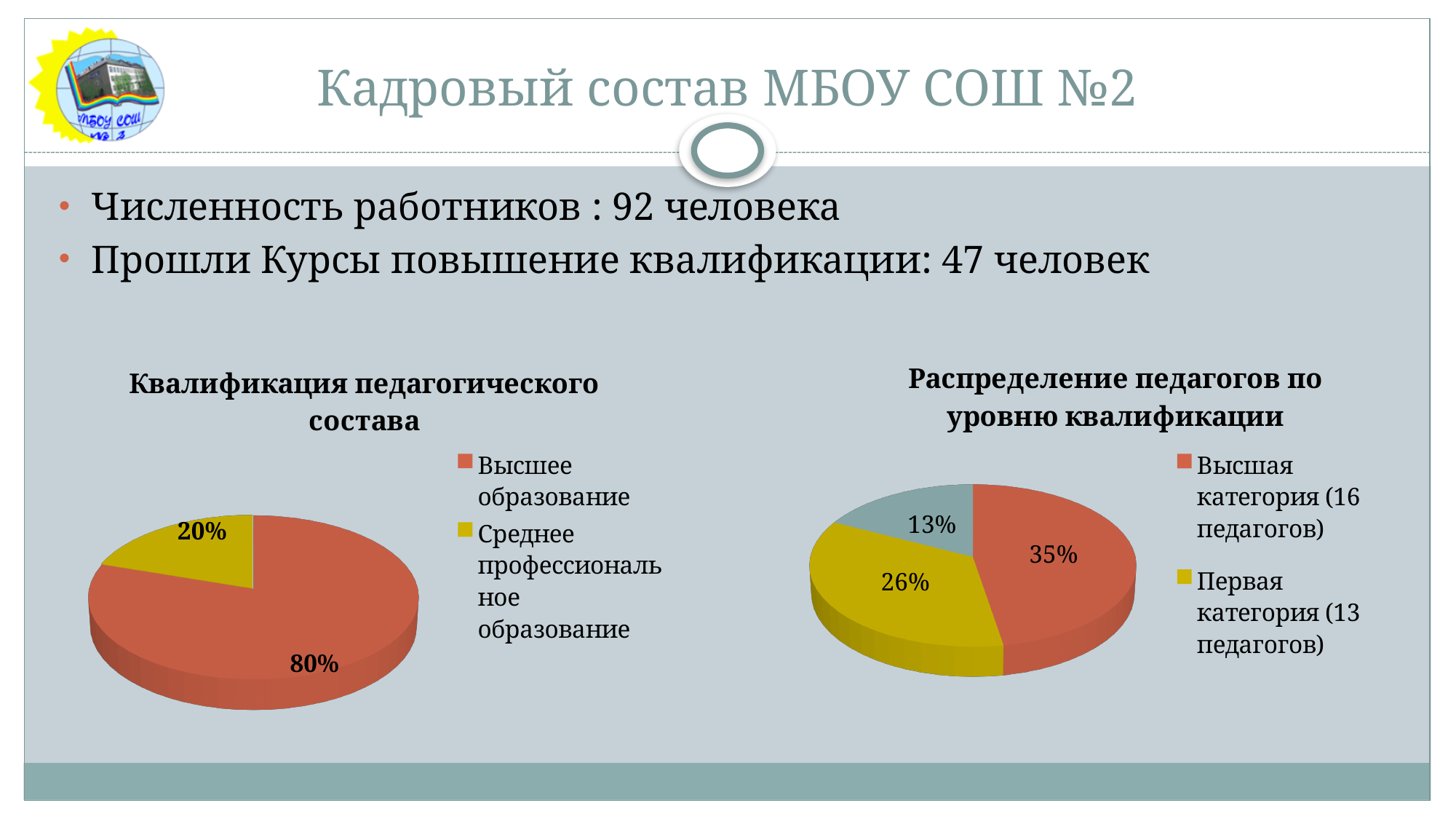
In the chart titled "Распределение педагогов по уровню квалификации", what percentage is shown for "Первая категория"? 26% How many slices does the chart titled "Квалификация педагогического состава" have? 2 In the chart titled "Квалификация педагогического состава", what share of the pie is "Среднее профессиональное образование"? 20% In the chart titled "Распределение педагогов по уровню квалификации", how many teachers does the legend give for "Первая категория"? 13 педагогов In the chart titled "Квалификация педагогического состава", which category has the largest slice? Высшее образование In the chart titled "Квалификация педагогического состава", what is the difference in percentage points between "Высшее образование" and "Среднее профессиональное образование"? 60 In the chart titled "Квалификация педагогического состава", what share of the pie is "Высшее образование"? 80% How many slices does the chart titled "Распределение педагогов по уровню квалификации" have? 3 In the chart titled "Распределение педагогов по уровню квалификации", what percentage is shown for "Высшая категория"? 35% In the chart titled "Распределение педагогов по уровню квалификации", which is larger: "Высшая категория" or "Первая категория"? Высшая категория In the chart titled "Распределение педагогов по уровню квалификации", what is the smallest percentage shown on a slice? 13% What kind of chart is the left chart, "Квалификация педагогического состава"? Pie chart